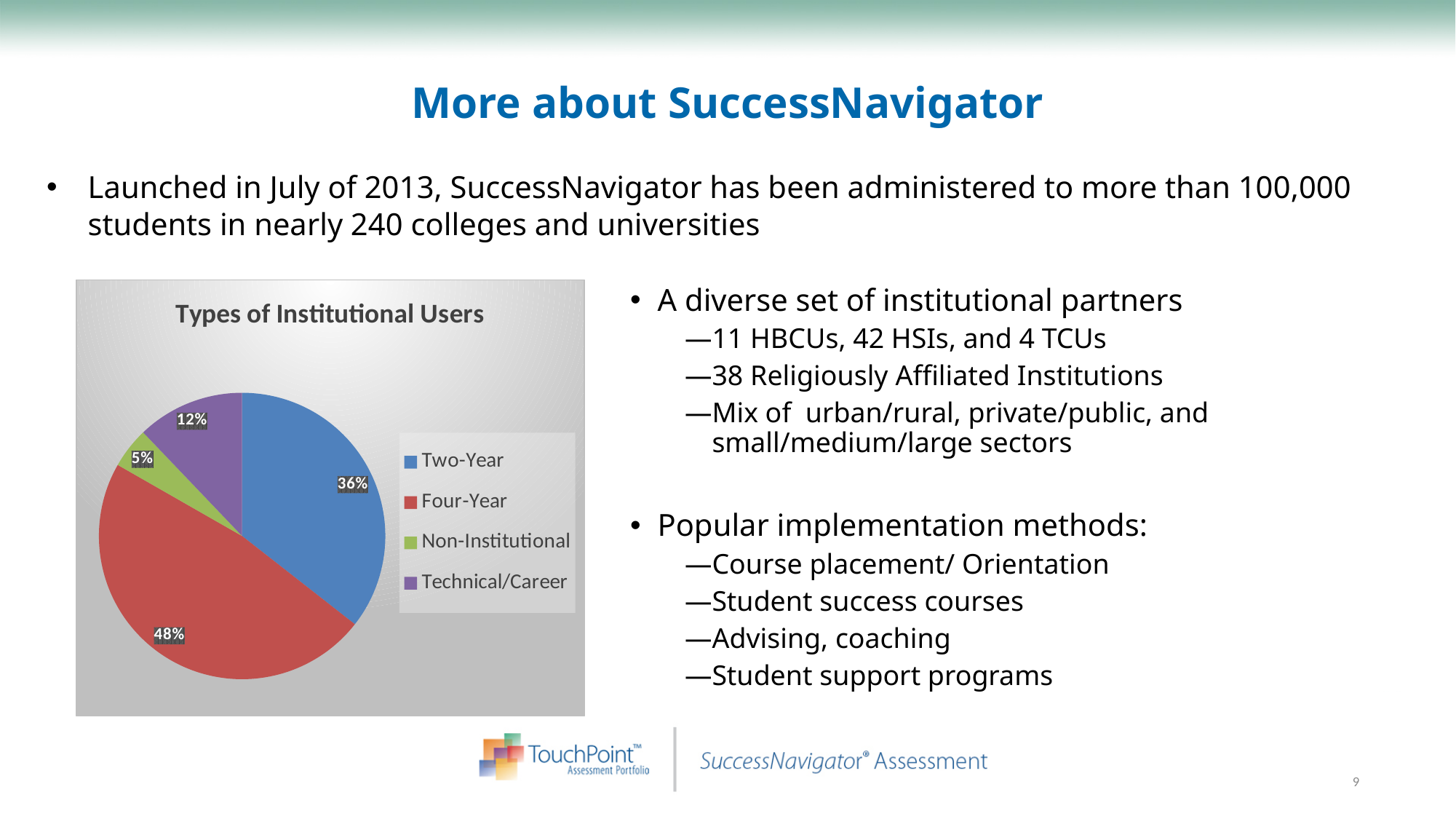
Which category has the largest share of the pie? Four-Year What type of chart is shown on the slide? Pie chart What share of the pie is Non-Institutional? 5% What share of the pie is Four-Year? 48% Which is larger, Technical/Career or Non-Institutional? Technical/Career How many categories does the pie chart have? 4 What share of the pie is Technical/Career? 12% What is the difference in percentage points between Four-Year and Two-Year? 12 Which colour represents Four-Year in the pie chart? Red What share of the pie is Two-Year? 36% What is the title of the chart? Types of Institutional Users Which category has the smallest share of the pie? Non-Institutional